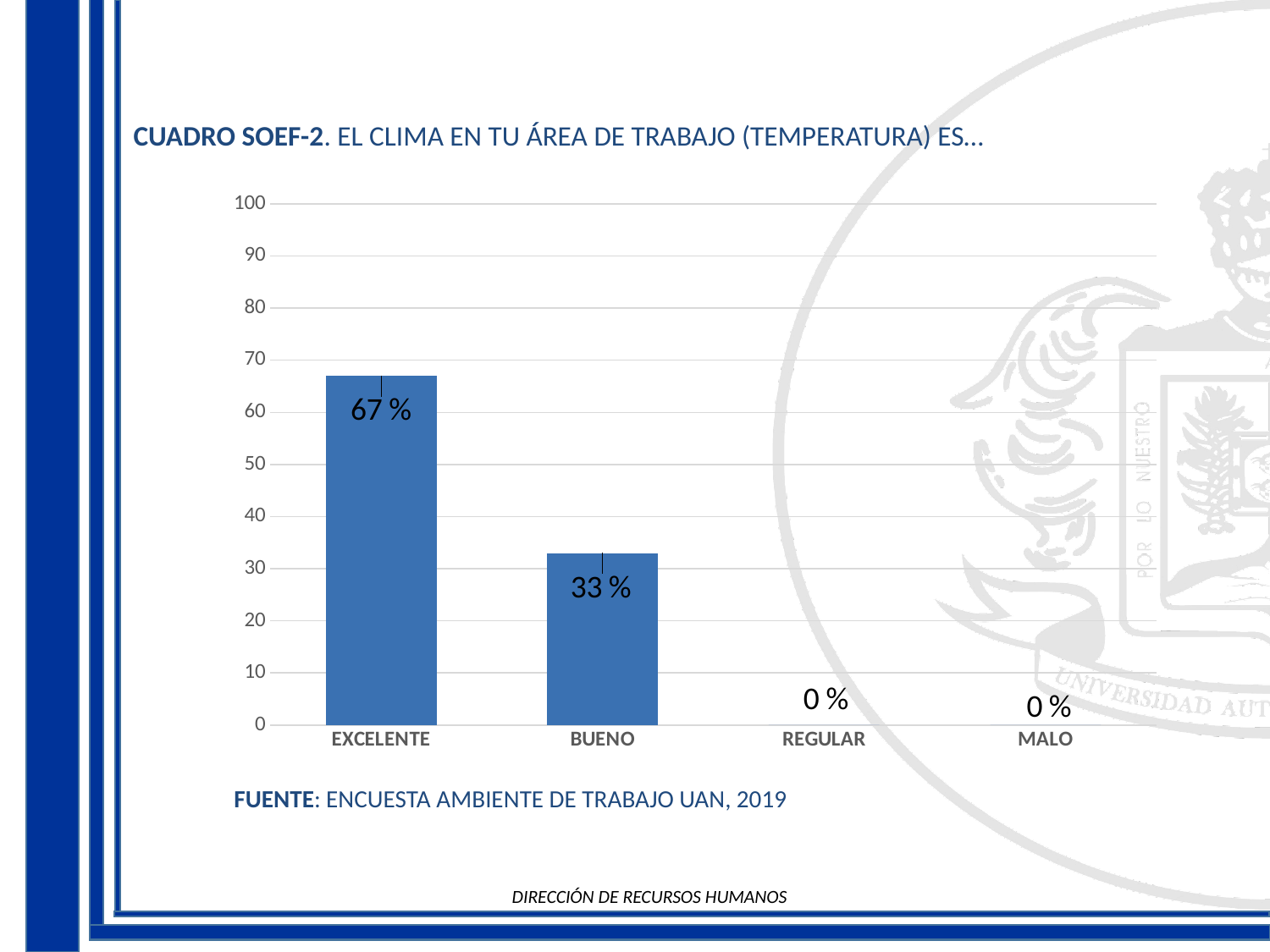
What is the value for BUENO? 33 % What is the value for MALO? 0 % Is the value for EXCELENTE greater or less than 60? greater How many categories are shown on the x axis? 4 Which category has the highest value? EXCELENTE Is the value for BUENO greater or less than 40? less What is the value for EXCELENTE? 67 % What source is cited below the chart? ENCUESTA AMBIENTE DE TRABAJO UAN, 2019 What is the value for REGULAR? 0 % What is the difference between the values for EXCELENTE and BUENO? 34 % What kind of chart is shown on the slide? bar chart Which is larger, the value for EXCELENTE or the value for BUENO? EXCELENTE